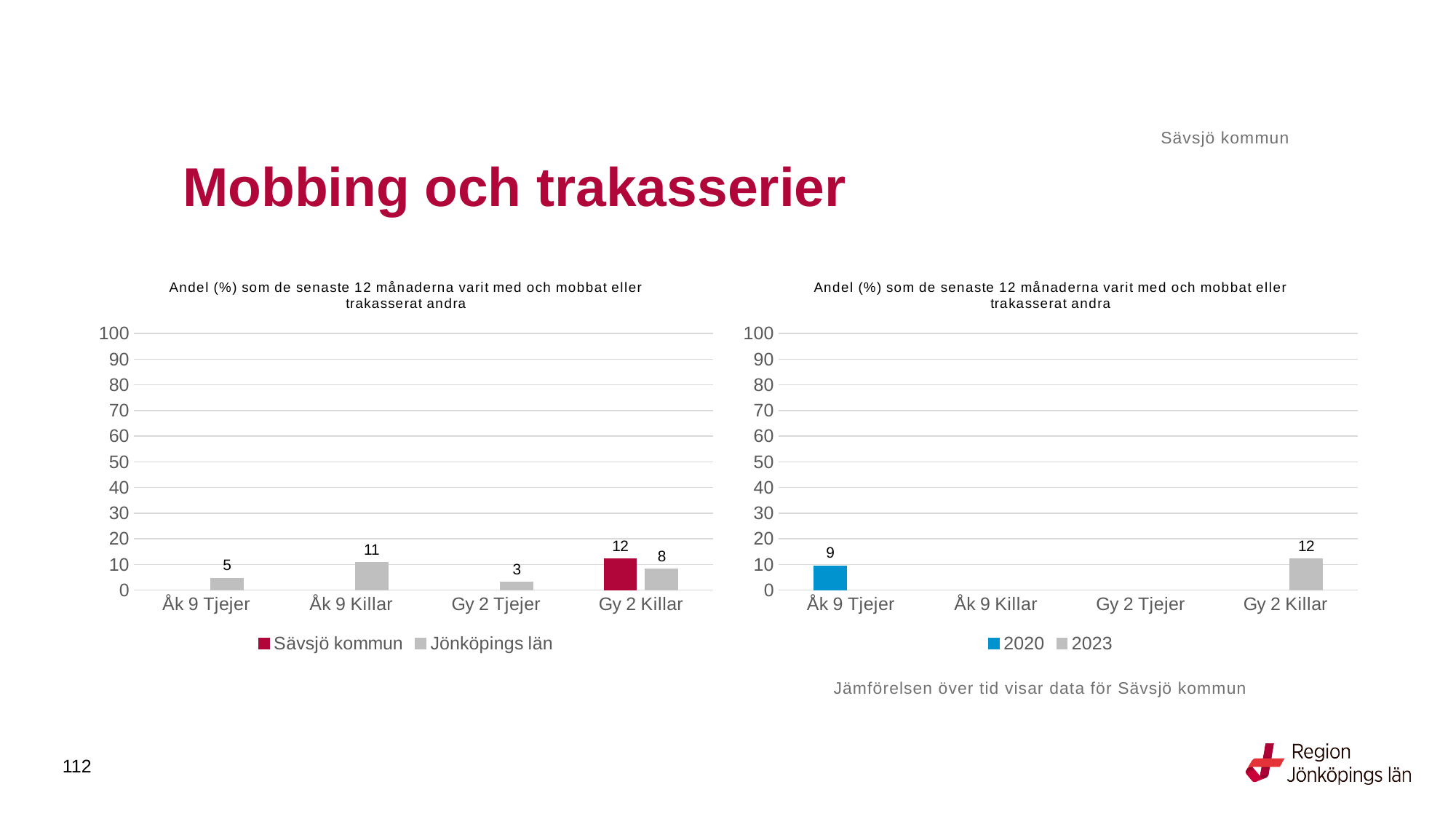
In the left chart, how many series does the legend list? 2 In the left chart, which is larger for Jönköpings län: Åk 9 Tjejer or Gy 2 Tjejer? Åk 9 Tjejer In the right chart, what are the two series listed in the legend? 2020 and 2023 In the left chart, what is the value for Jönköpings län for Åk 9 Killar? 11 In the right chart, what is the value for 2020 for Åk 9 Tjejer? 9 In the left chart, what is the value for Sävsjö kommun for Gy 2 Killar? 12 In the right chart, how many categories are shown on the x axis? 4 In the left chart, what is the difference between Sävsjö kommun and Jönköpings län for Gy 2 Killar? 4 In the left chart, which category has the highest value for Jönköpings län? Åk 9 Killar In the left chart, which category has the lowest value for Jönköpings län? Gy 2 Tjejer In the right chart, what is the value for 2023 for Gy 2 Killar? 12 What kind of chart is the right chart? Bar chart